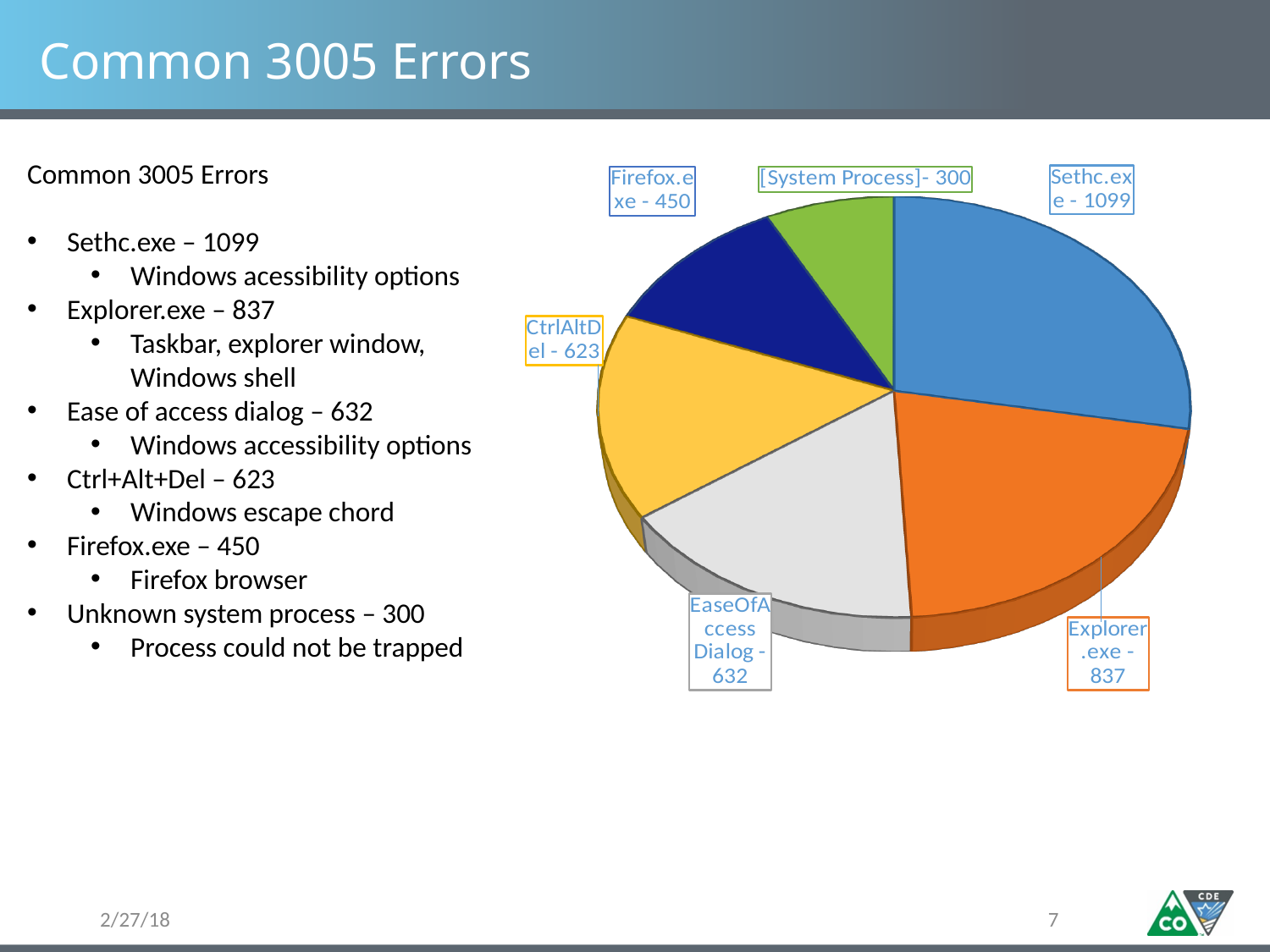
What is the value shown for CtrlAltDel in the pie chart? 623 What is the difference between the values for Sethc.exe and Explorer.exe? 262 What is the value shown for Sethc.exe in the pie chart? 1099 Which slice of the pie chart has the smallest value? [System Process] Which slice of the pie chart has the largest value? Sethc.exe What colour is the Explorer.exe slice in the pie chart? Orange What is the value shown for Explorer.exe in the pie chart? 837 What is the value shown for [System Process] in the pie chart? 300 What kind of chart is shown on the slide? Pie chart Which has a larger value, EaseOfAccess Dialog or Firefox.exe? EaseOfAccess Dialog How many slices does the pie chart have? 6 What is the total of all the values in the pie chart? 3941